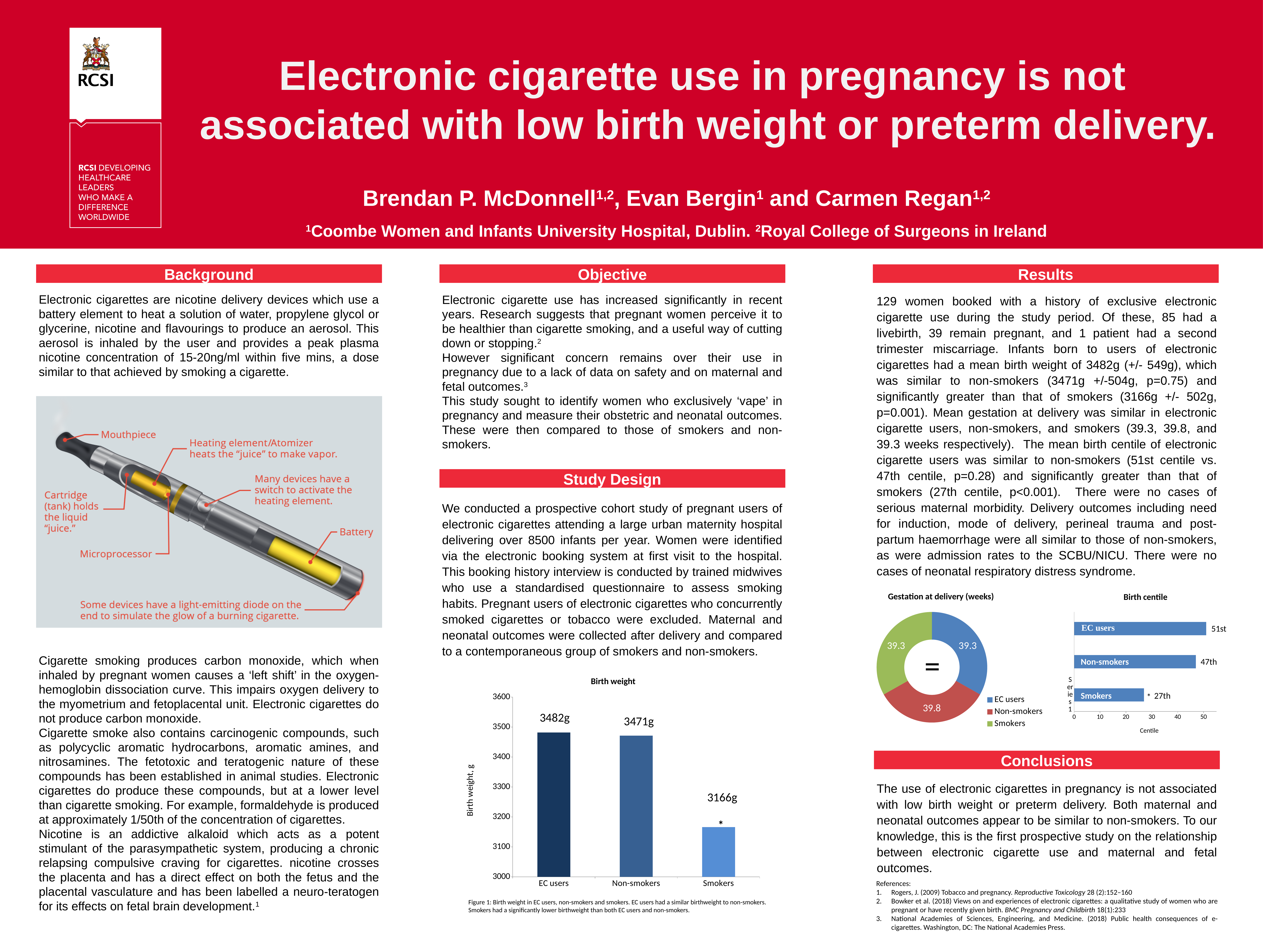
In the Birth weight chart, what is the value for Smokers? 3166g What kind of chart is the Gestation at delivery (weeks) chart? doughnut chart In the Birth centile chart, what is the value for Non-smokers? 47th In the Birth centile chart, which group has the highest birth centile? EC users In the Birth weight chart, which category has the lowest birth weight? Smokers In the Gestation at delivery (weeks) chart, how many entries does the legend list? 3 In the Birth centile chart, is the value for Smokers greater or less than 30? less In the Birth weight chart, what is the difference between the birth weight of EC users and Smokers? 316g In the Gestation at delivery (weeks) chart, what is the value for Non-smokers? 39.8 In the Birth weight chart, how many categories are shown on the x axis? 3 What kind of chart is the Birth weight chart? bar chart In the Birth weight chart, what is the mean birth weight for EC users? 3482g